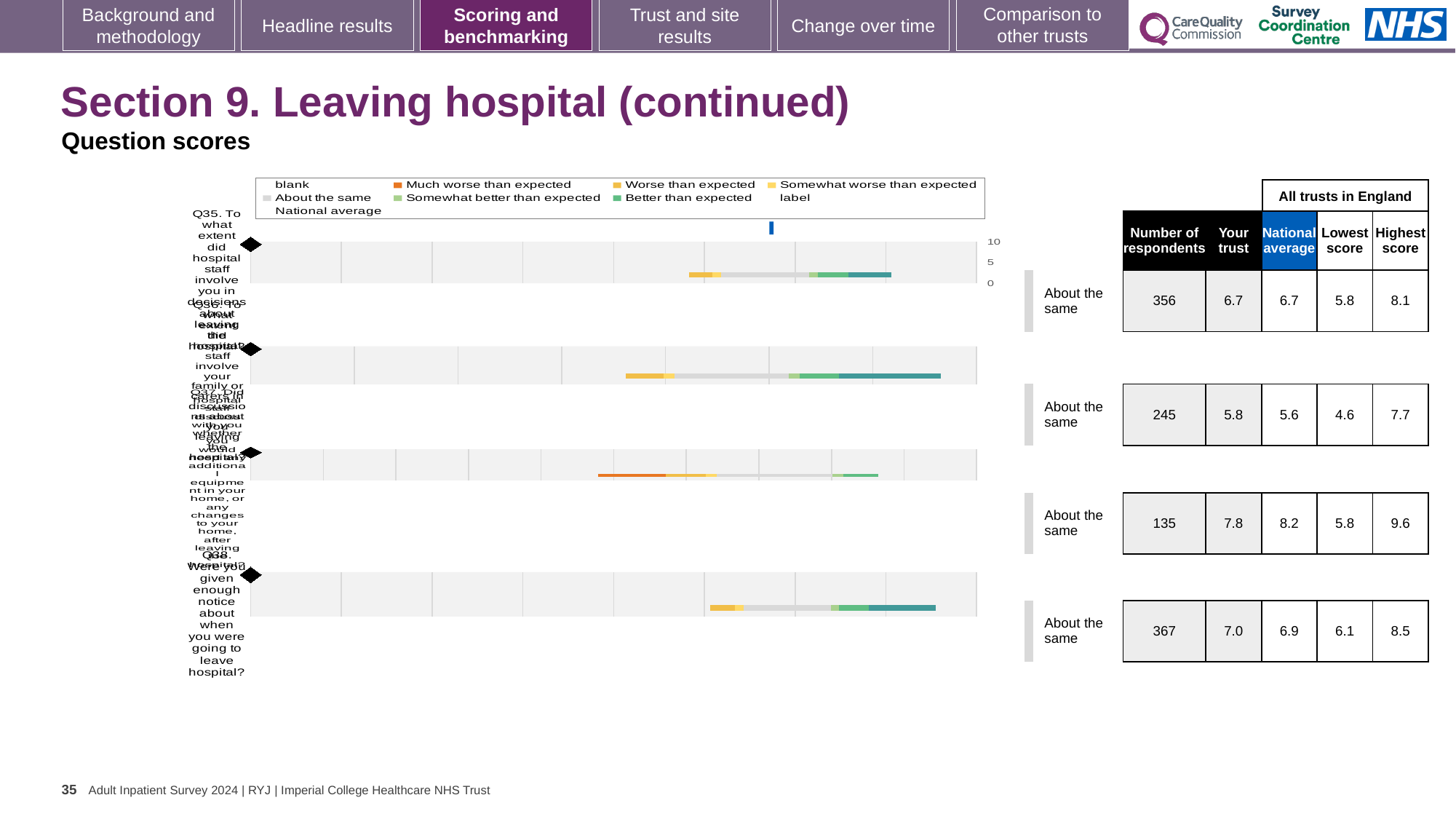
What is the number of respondents for Q35? 356 Which question has the highest 'Your trust' score? Q37 What is the national average score for Q38? 6.9 What is the 'Your trust' score for Q37? 7.8 What is the difference between the highest score and the lowest score for Q37? 3.8 For Q36, which is larger: the 'Your trust' score or the national average? Your trust Which question has the lowest number of respondents? Q37 How many questions (bars) are plotted in the chart? 4 What is the highest score across all trusts in England for Q36? 7.7 What kind of chart is used to show the question scores on this slide? bar chart Which benchmark category is shown next to every question bar on this slide? About the same How many entries does the chart legend list? 9